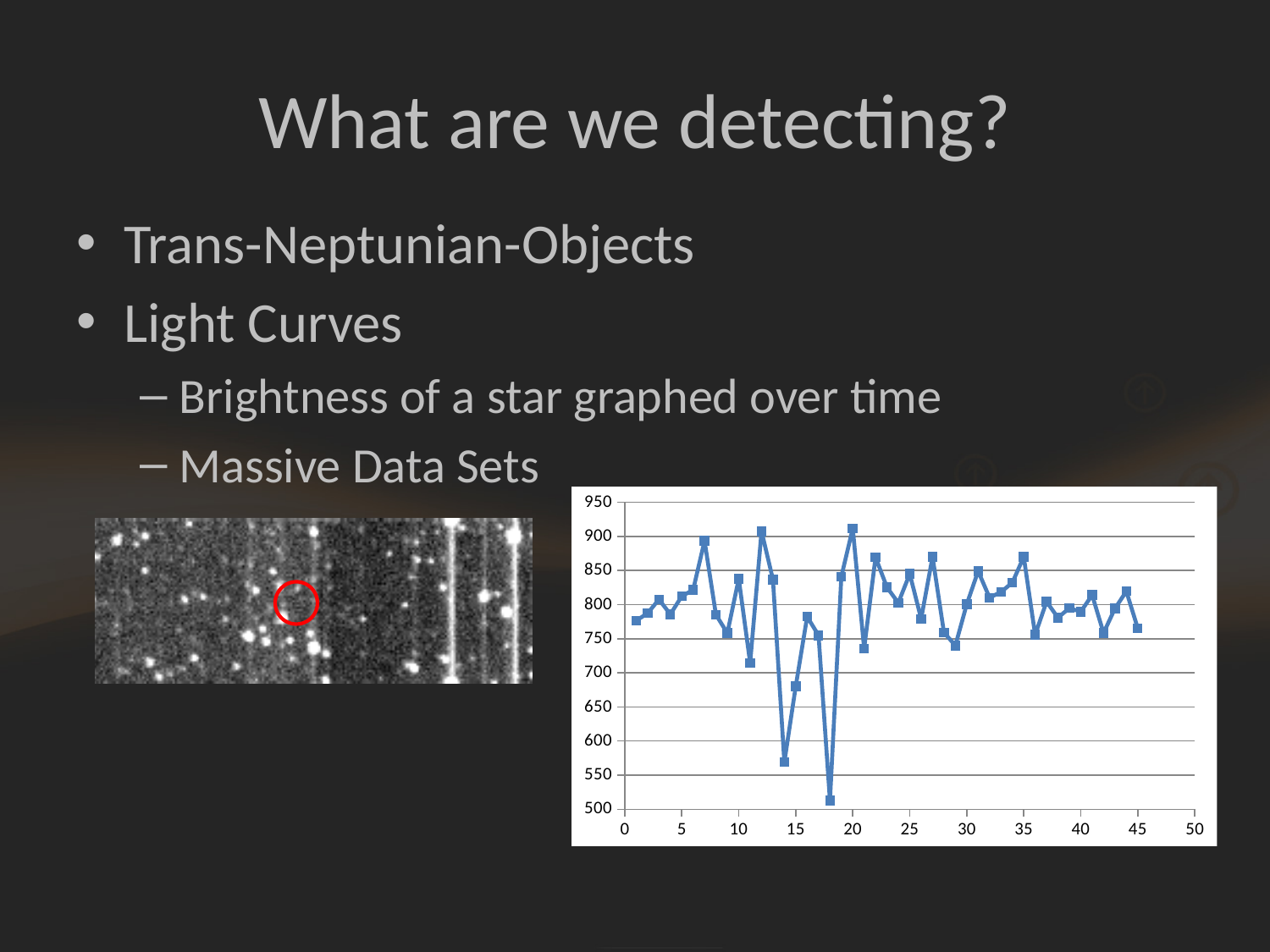
What kind of chart is shown on the slide? line chart Is the value at x = 16 greater or less than 700? greater Is the value at x = 20 greater or less than 900? greater Is the value at x = 35 greater or less than 850? greater What is the lowest value shown on the chart's vertical axis? 500 What is the highest value shown on the chart's horizontal axis? 50 Which is larger, the value at x = 18 or the value at x = 20? x = 20